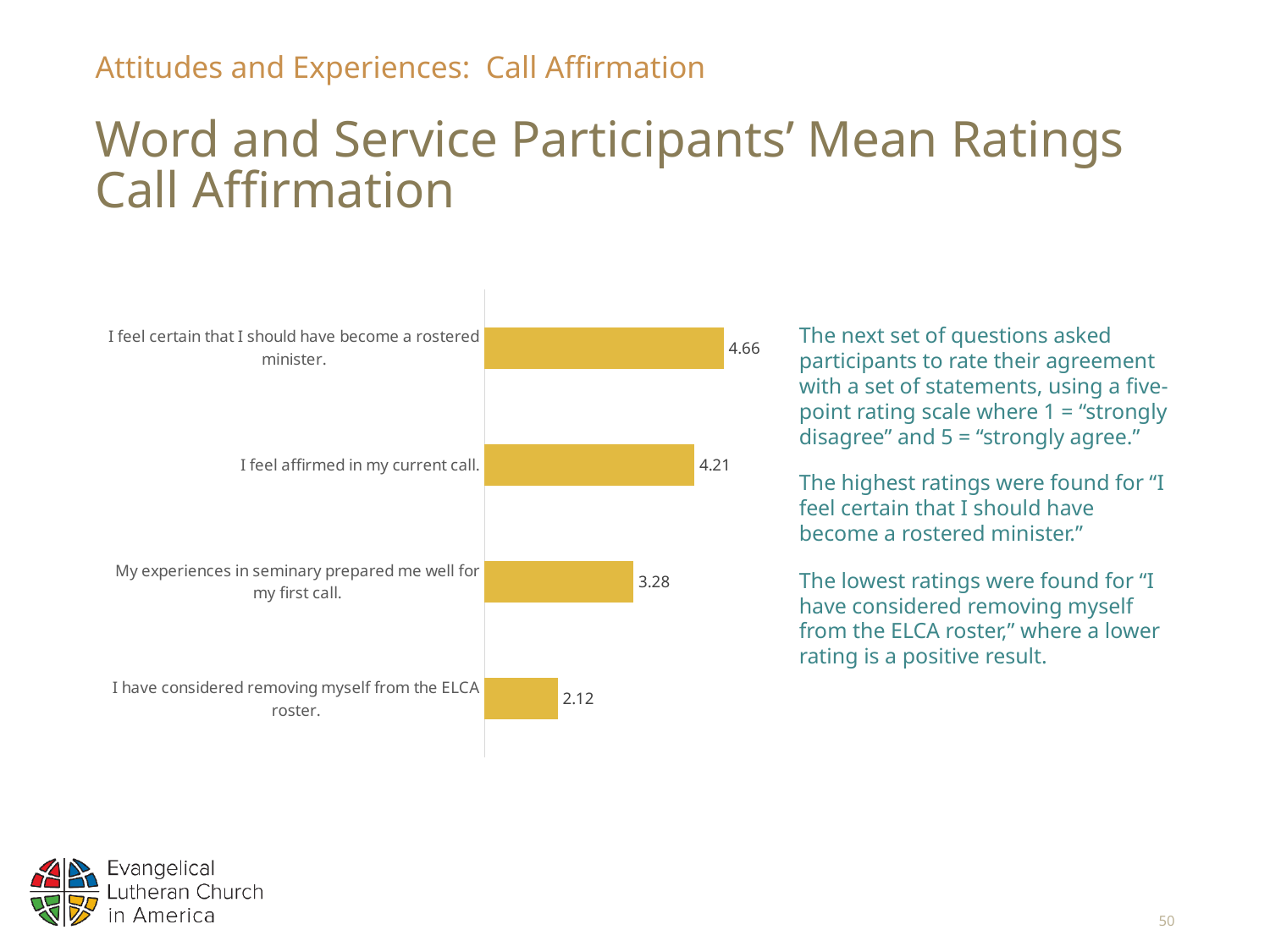
How many statements are shown in the chart? 4 Which statement has the lowest mean rating? I have considered removing myself from the ELCA roster. What is the mean rating for "I have considered removing myself from the ELCA roster."? 2.12 What is the mean rating for "I feel certain that I should have become a rostered minister."? 4.66 What is the mean rating for "My experiences in seminary prepared me well for my first call."? 3.28 What is the difference between the mean ratings for "I feel certain that I should have become a rostered minister." and "I feel affirmed in my current call."? 0.45 What is the difference between the mean ratings for "My experiences in seminary prepared me well for my first call." and "I have considered removing myself from the ELCA roster."? 1.16 What colour are the bars in the chart? Gold Which statement has the highest mean rating? I feel certain that I should have become a rostered minister. What kind of chart is shown on the slide? Bar chart Which has a higher mean rating: "I feel affirmed in my current call." or "My experiences in seminary prepared me well for my first call."? I feel affirmed in my current call. What is the mean rating for "I feel affirmed in my current call."? 4.21